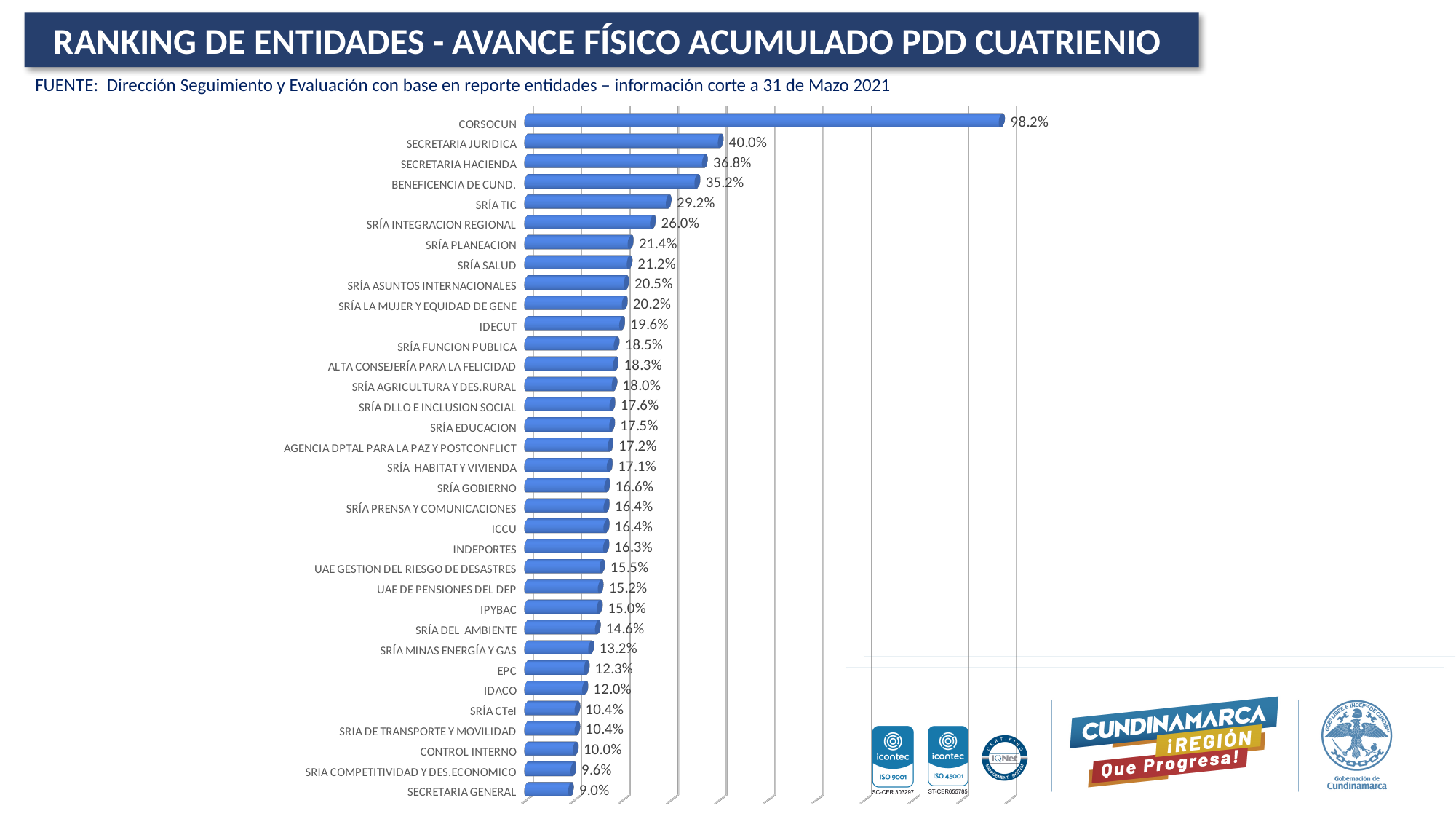
What is the difference between the values for CORSOCUN and SECRETARIA GENERAL? 89.2% What type of chart is shown on the slide? Bar chart How many entities are shown in the chart? 34 What is the difference between the values for SECRETARIA JURIDICA and BENEFICENCIA DE CUND.? 4.8% Which has a larger value, EPC or IDACO? EPC What is the value shown for SECRETARIA HACIENDA? 36.8% What is the value shown for IDECUT? 19.6% Which has a larger value, SRÍA TIC or SRÍA INTEGRACION REGIONAL? SRÍA TIC Which entity has the lowest value in the chart? SECRETARIA GENERAL What is the value shown for CORSOCUN? 98.2% What is the value shown for SRÍA MINAS ENERGÍA Y GAS? 13.2% Which entity has the highest value in the chart? CORSOCUN